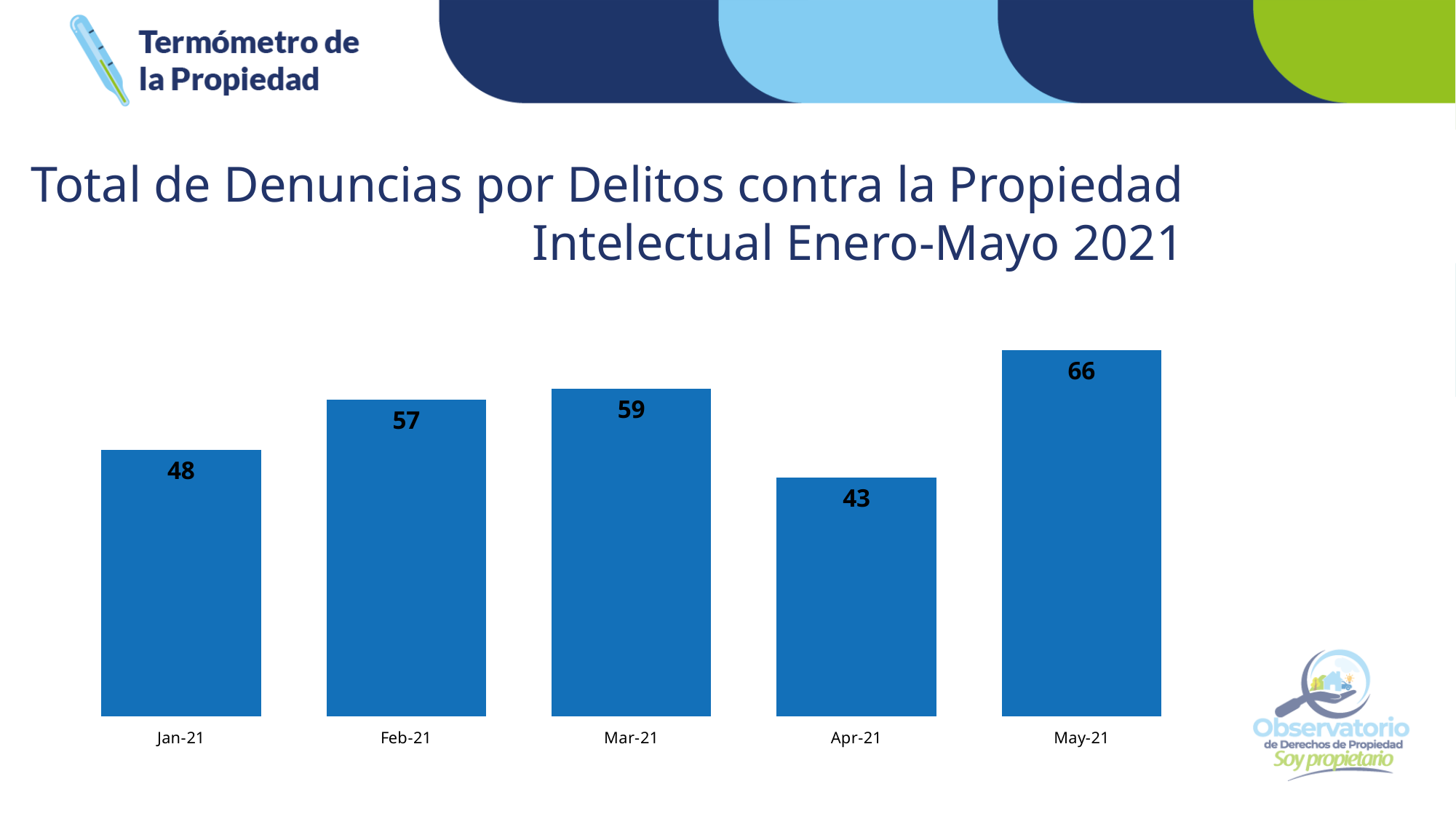
How many months are shown on the chart? 5 Do the values rise or fall from Mar-21 to Apr-21? Fall Which is larger, the value for Feb-21 or the value for Jan-21? Feb-21 Which month has the lowest value? Apr-21 Which month has the highest value? May-21 What is the difference between the values for May-21 and Apr-21? 23 What is the value for Apr-21? 43 What is the value for Jan-21? 48 What is the value for May-21? 66 What kind of chart is shown on the slide? Bar chart What is the title of the chart? Total de Denuncias por Delitos contra la Propiedad Intelectual Enero-Mayo 2021 What is the difference between the values for Mar-21 and Feb-21? 2